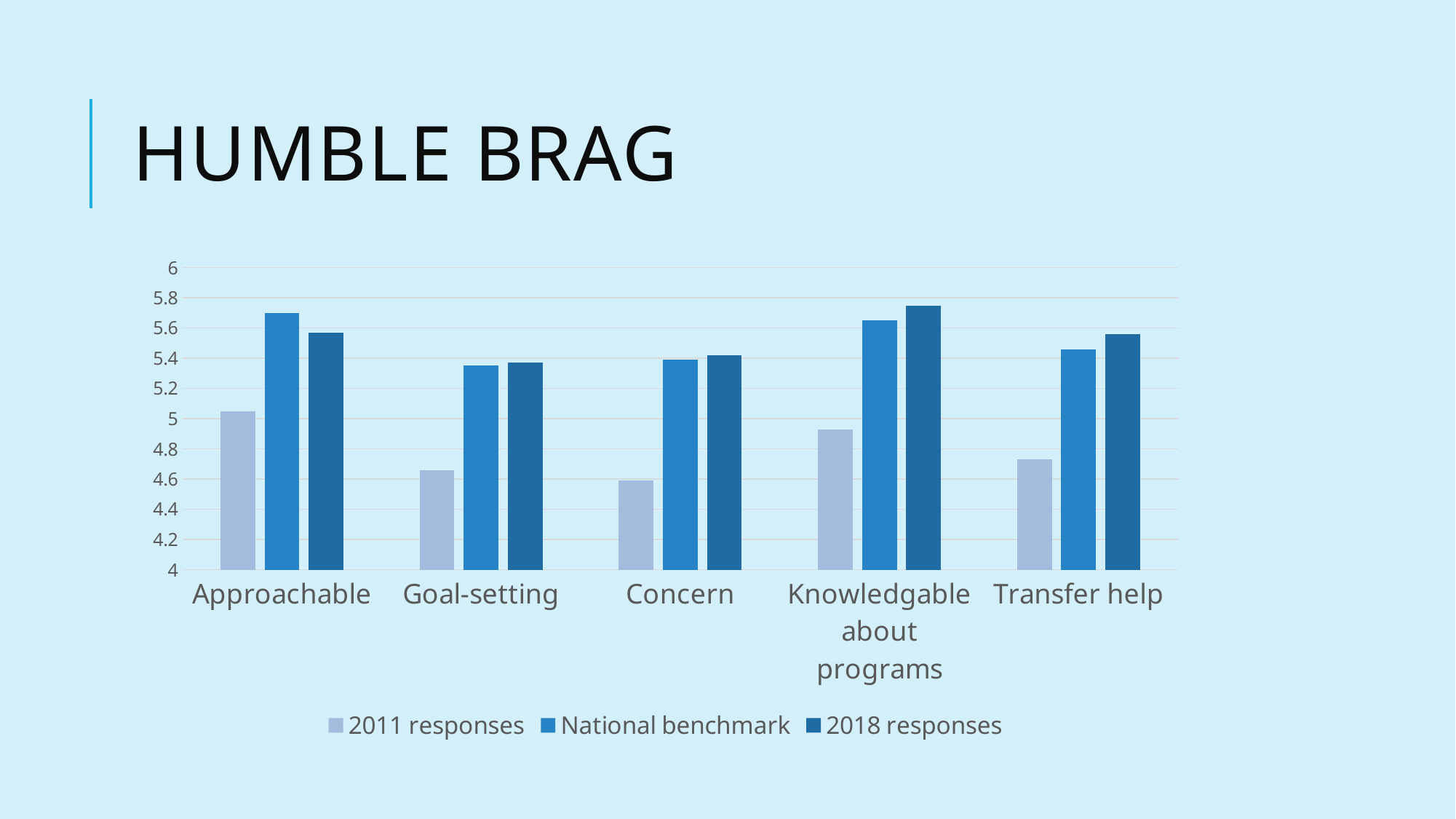
What is the title of the slide containing the chart? HUMBLE BRAG Which series is shown in the lightest colour in the legend? 2011 responses Is the 2011 responses value for Knowledgable about programs greater or less than 5? less Is the 2011 responses value for Goal-setting greater or less than 4.8? less What kind of chart is shown on the slide? Bar chart For Approachable, which is larger: the National benchmark or the 2018 responses? National benchmark How many categories are shown along the x axis of the chart? 5 Which category has the highest 2011 responses value? Approachable For Knowledgable about programs, which is larger: the National benchmark or the 2018 responses? 2018 responses How many series does the chart's legend list? 3 Is the 2018 responses value for Knowledgable about programs greater or less than 5.6? greater Which category has the highest 2018 responses value? Knowledgable about programs